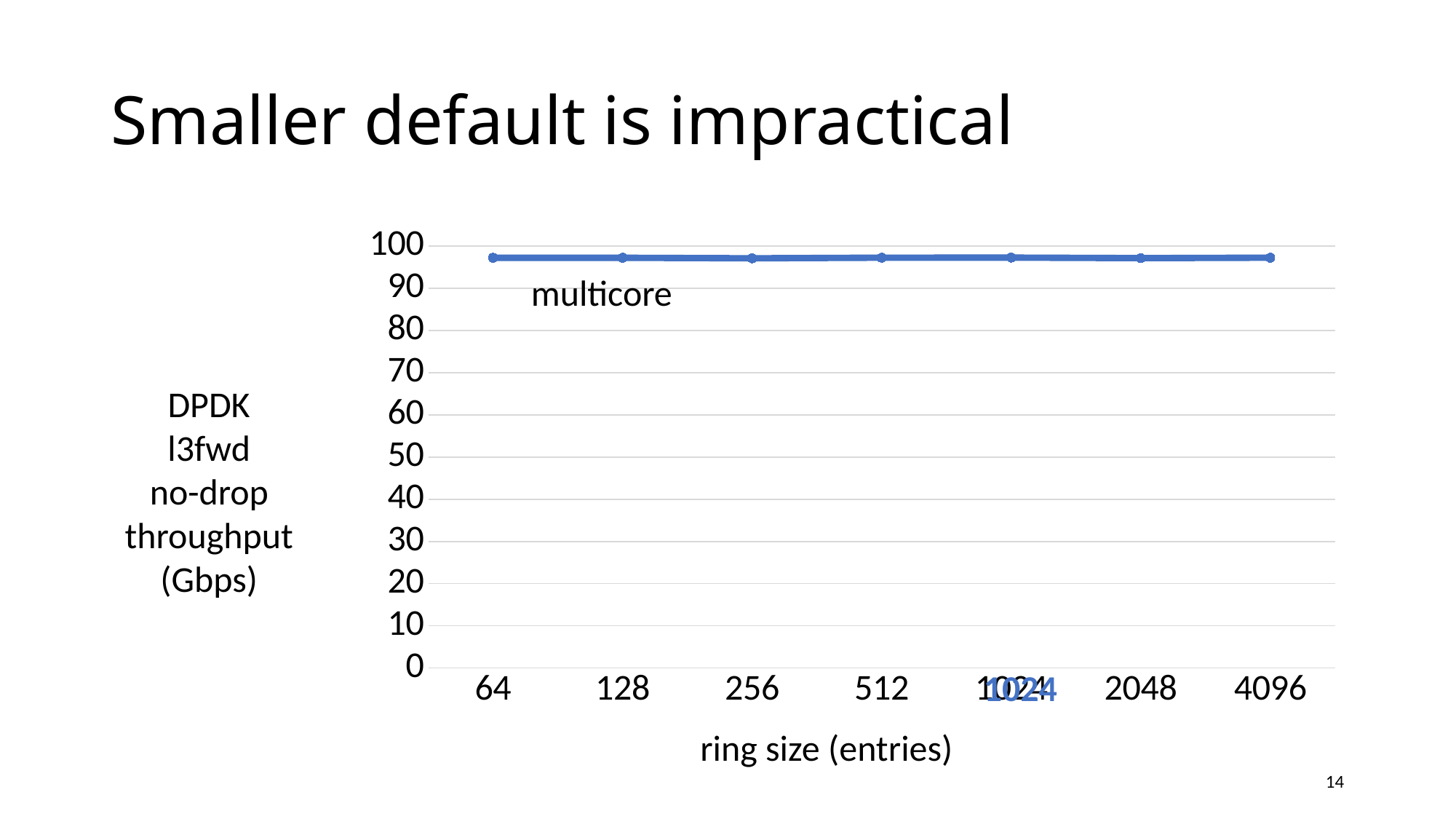
How many ring size values are plotted along the x axis? 7 Is the throughput value for ring size 64 greater or less than 90? greater What is the name of the plotted series? multicore Is the throughput value for ring size 2048 greater or less than 80? greater What is the smallest ring size shown on the x axis? 64 What kind of chart is shown on the slide? line chart Is the throughput value for ring size 512 greater or less than 50? greater What is the largest ring size shown on the x axis? 4096 Do the plotted throughput values rise, fall, or stay roughly flat as ring size increases from 64 to 4096? stay roughly flat What is the label of the x axis? ring size (entries)